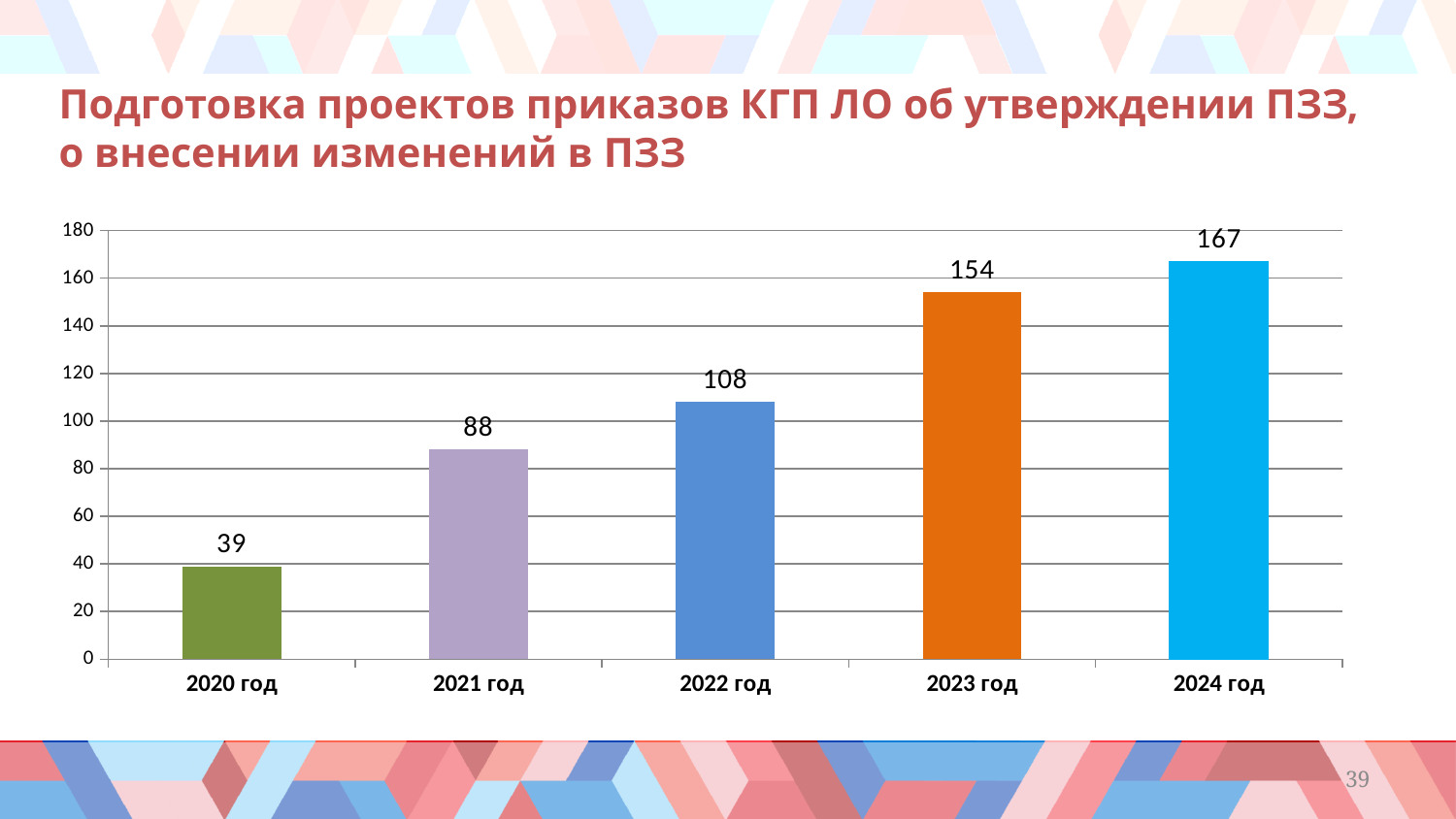
What is the difference between the values for 2023 год and 2021 год? 66 What is the value for 2024 год? 167 Which year has the highest value? 2024 год What is the value for 2020 год? 39 What kind of chart is shown on the slide? bar chart Do the values rise or fall from 2020 год to 2024 год? rise Is the value for 2023 год greater or less than 140? greater Which is larger, the value for 2021 год or the value for 2022 год? 2022 год What colour is the bar for 2023 год? orange Which year has the lowest value? 2020 год What is the value for 2022 год? 108 How many years are shown on the chart? 5